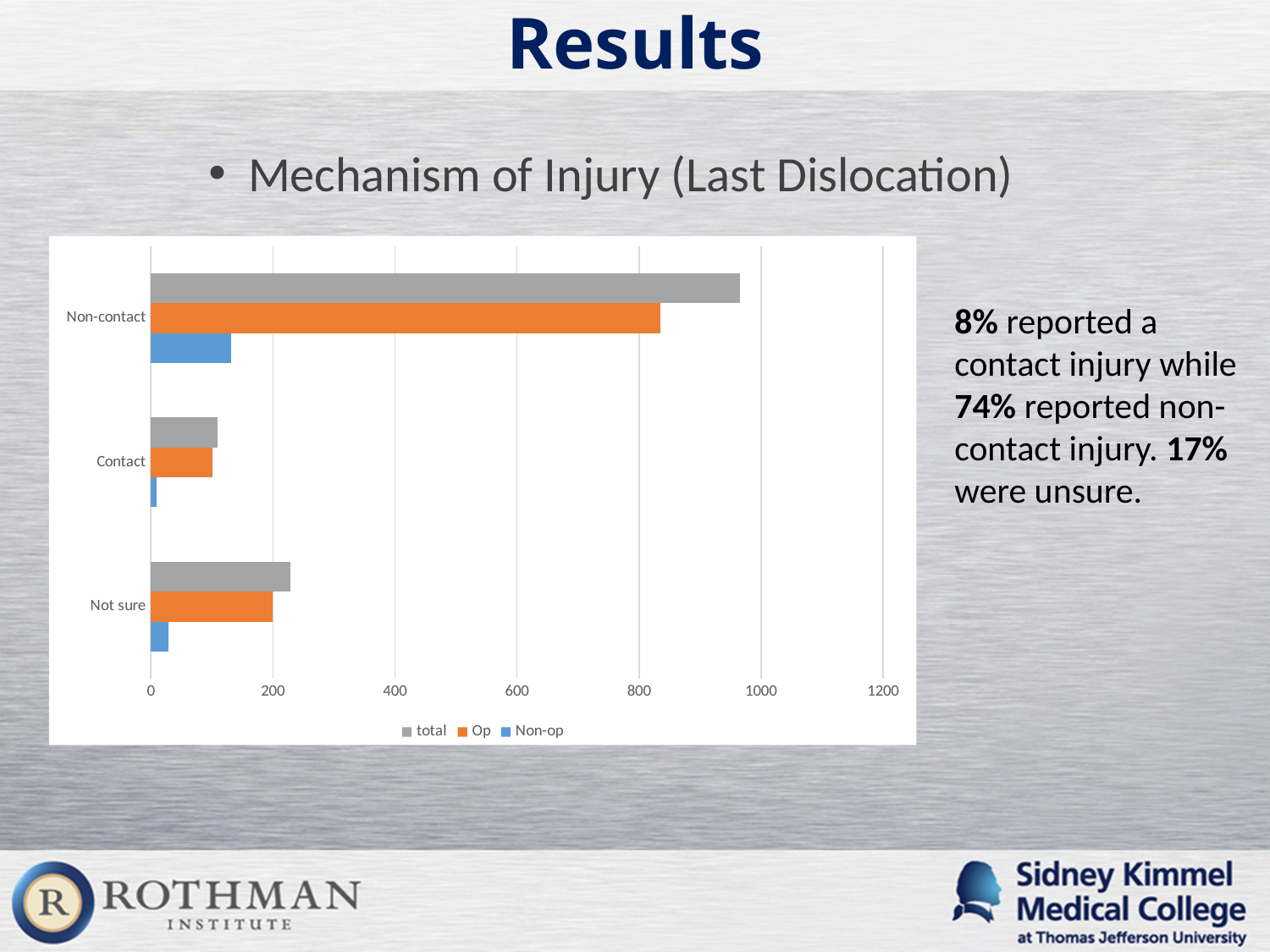
Is the total value for Non-contact greater or less than 800? greater Is the total value for Contact greater or less than 200? less Which category has the lowest total value? Contact How many series does the chart legend list? 3 Is the Op value for Non-contact greater or less than 600? greater Which category has the larger total value, Not sure or Contact? Not sure What kind of chart is shown on the slide? bar chart How many categories are shown on the chart? 3 What are the three series listed in the chart legend? total, Op, Non-op Which series is shown in orange in the chart? Op Which category has the highest total value? Non-contact